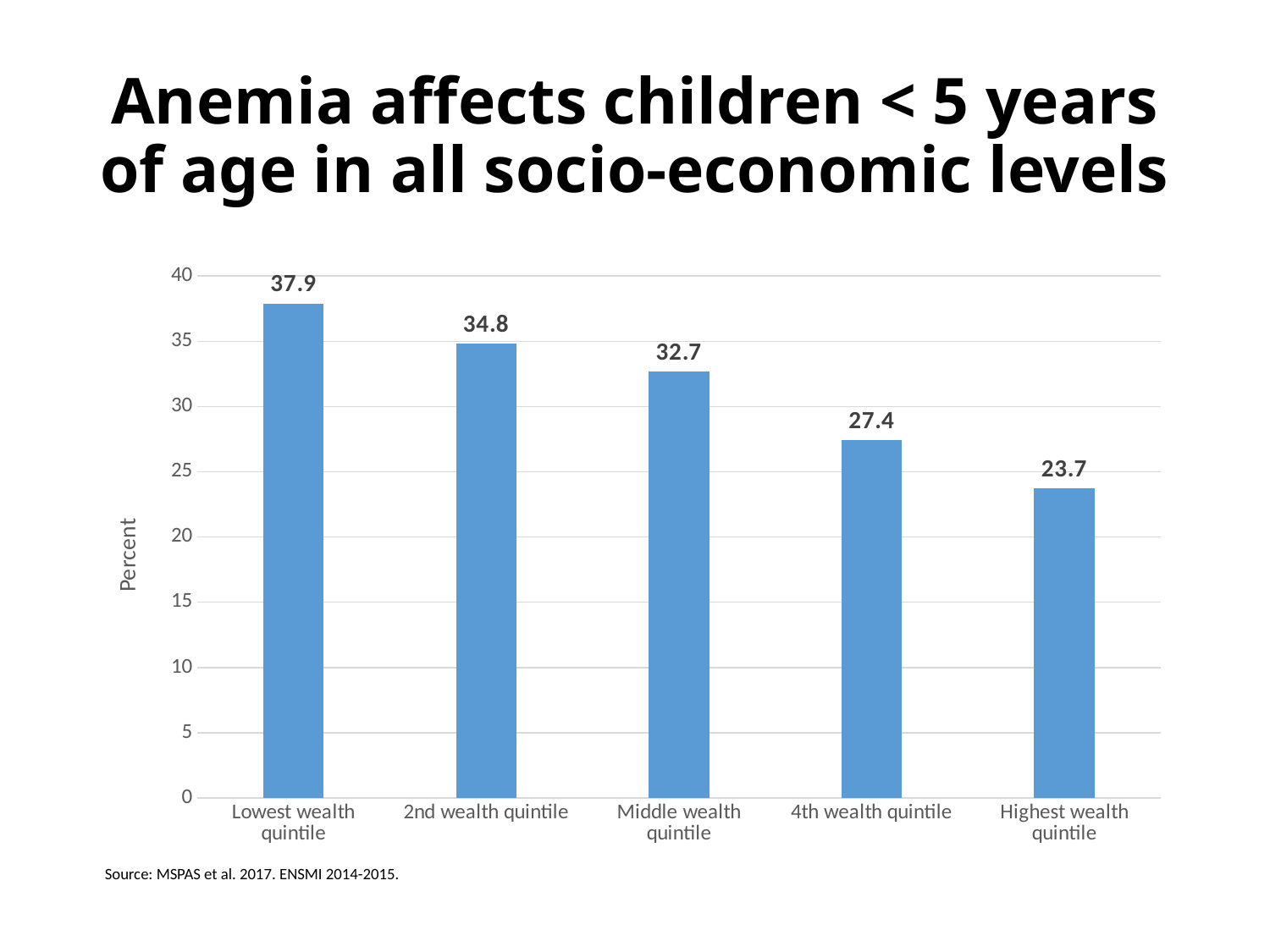
What is the difference between the 2nd wealth quintile and the 4th wealth quintile? 7.4 How many wealth quintile categories are shown on the chart? 5 Is the value for the 4th wealth quintile greater or less than 30? less Which wealth quintile has the highest anemia percentage? Lowest wealth quintile Which is larger, the value for the 2nd wealth quintile or the 4th wealth quintile? 2nd wealth quintile What is the value for the Middle wealth quintile? 32.7 What is the difference between the values for the Lowest wealth quintile and the Highest wealth quintile? 14.2 Which wealth quintile has the lowest anemia percentage? Highest wealth quintile Do the values rise or fall moving from the Lowest wealth quintile to the Highest wealth quintile? Fall What kind of chart is shown on the slide? Bar chart What is the value shown for the Highest wealth quintile? 23.7 What is the anemia percentage for the Lowest wealth quintile? 37.9